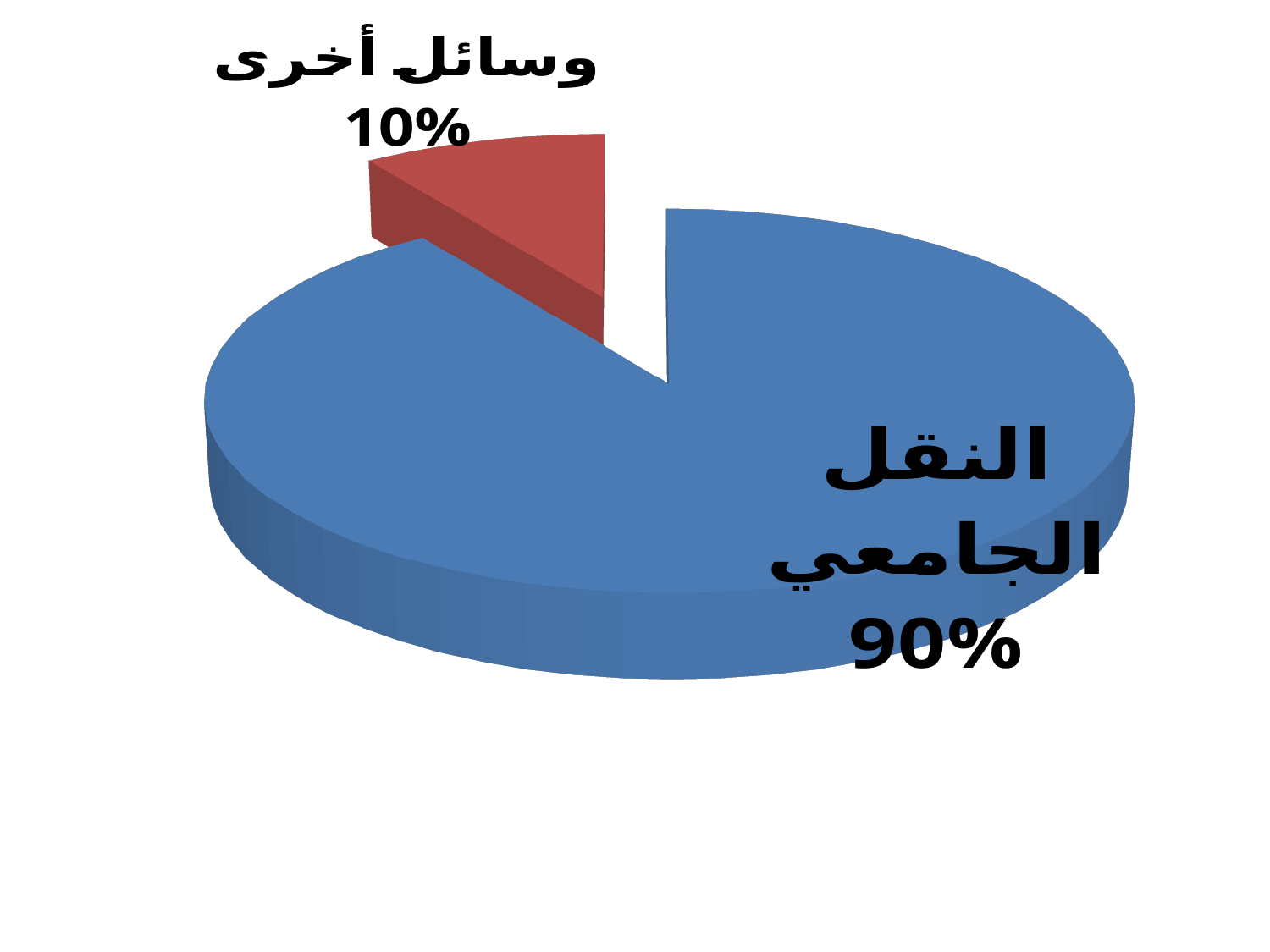
How many slices does the pie chart have? 2 What share of the pie does وسائل أخرى represent? 10% Which slice of the pie is the largest? النقل الجامعي Which is larger, the share for النقل الجامعي or the share for وسائل أخرى? النقل الجامعي What is the difference in percentage points between النقل الجامعي and وسائل أخرى? 80 What colour is the slice for وسائل أخرى? Red Which slice of the pie is the smallest? وسائل أخرى What colour is the slice for النقل الجامعي? Blue What kind of chart is shown on the slide? Pie chart What share of the pie does النقل الجامعي represent? 90%